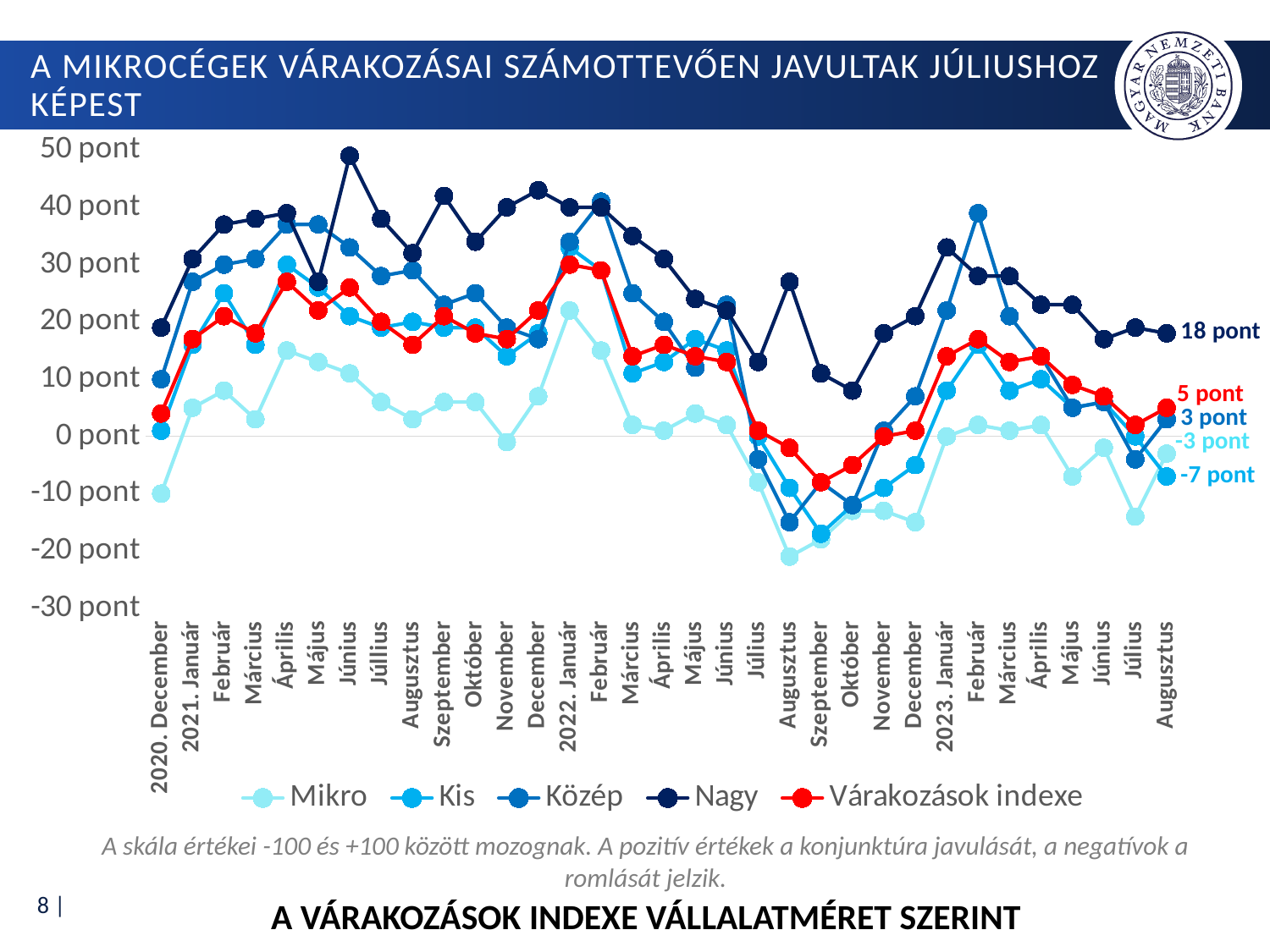
What is the value of the Közép series in 2023 Augusztus? 3 pont Is the value for Nagy in 2021 Június greater or less than 40 pont? greater What is the value of the Kis series in 2023 Augusztus? -7 pont What is the value of the Nagy series in 2023 Augusztus? 18 pont What is the difference between the Nagy and the Várakozások indexe values in 2023 Augusztus? 13 pont What is the title of the chart shown below the legend? A várakozások indexe vállalatméret szerint Which series has the highest value in 2023 Augusztus? Nagy Which series has the lowest value in 2023 Augusztus? Kis How many series does the legend list? 5 Is the value for Mikro in 2022 Augusztus greater or less than -10 pont? less What is the value of the Várakozások indexe series in 2023 Augusztus? 5 pont What kind of chart is shown on the slide? line chart